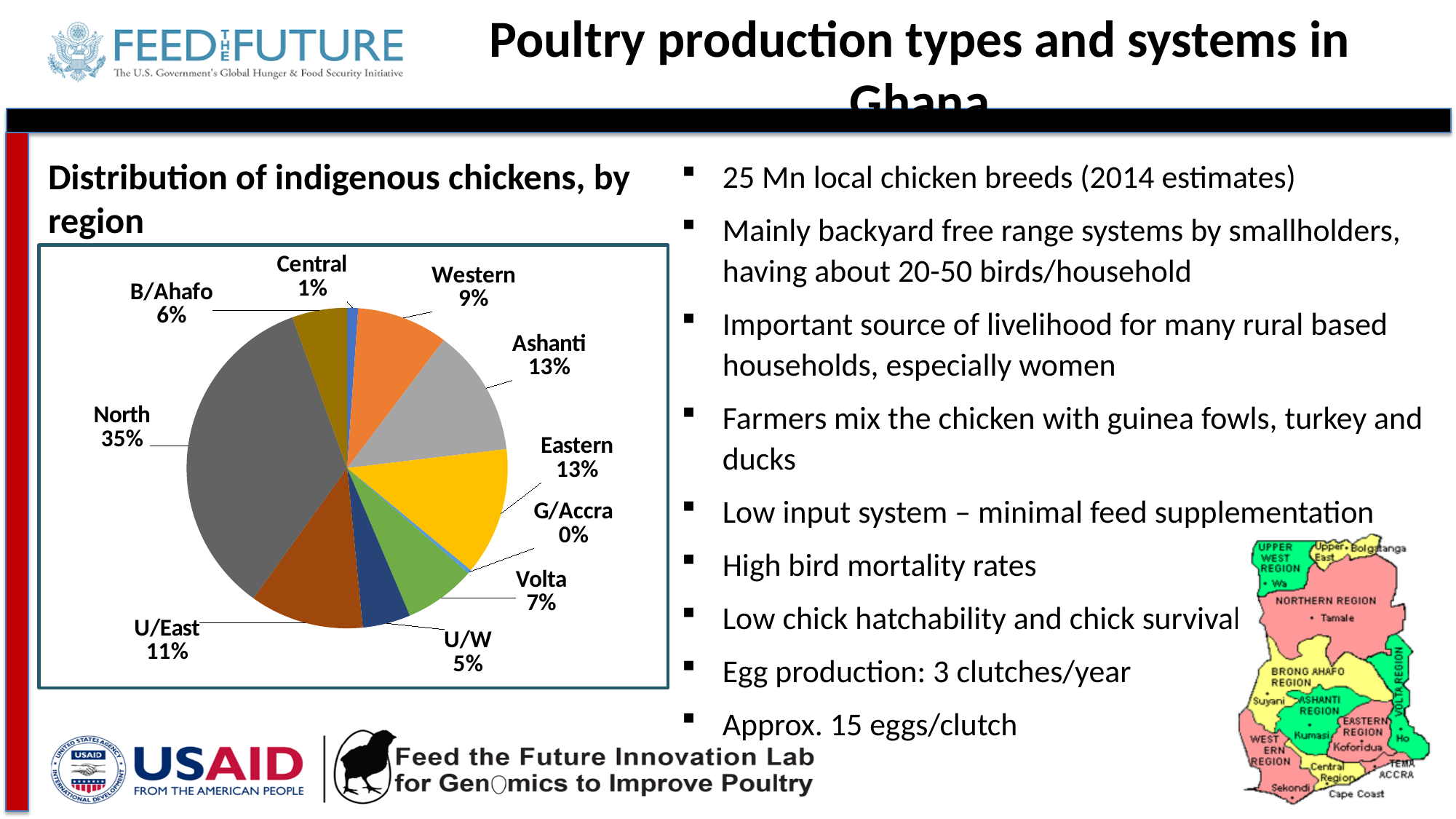
How many regions are shown in the pie chart? 10 Which region has the largest share of indigenous chickens? North What is the title of the pie chart? Distribution of indigenous chickens, by region What type of chart is shown on the slide? pie chart What is the value shown for U/East? 11% What is the share of indigenous chickens in the North region? 35% What is the difference between the shares of North and U/East? 24% What is the combined share of Ashanti and Eastern? 26% What percentage of indigenous chickens is in the Western region? 9% Which region has the smallest share of indigenous chickens? G/Accra What is the value shown for Volta? 7% Which has a larger share, B/Ahafo or Western? Western